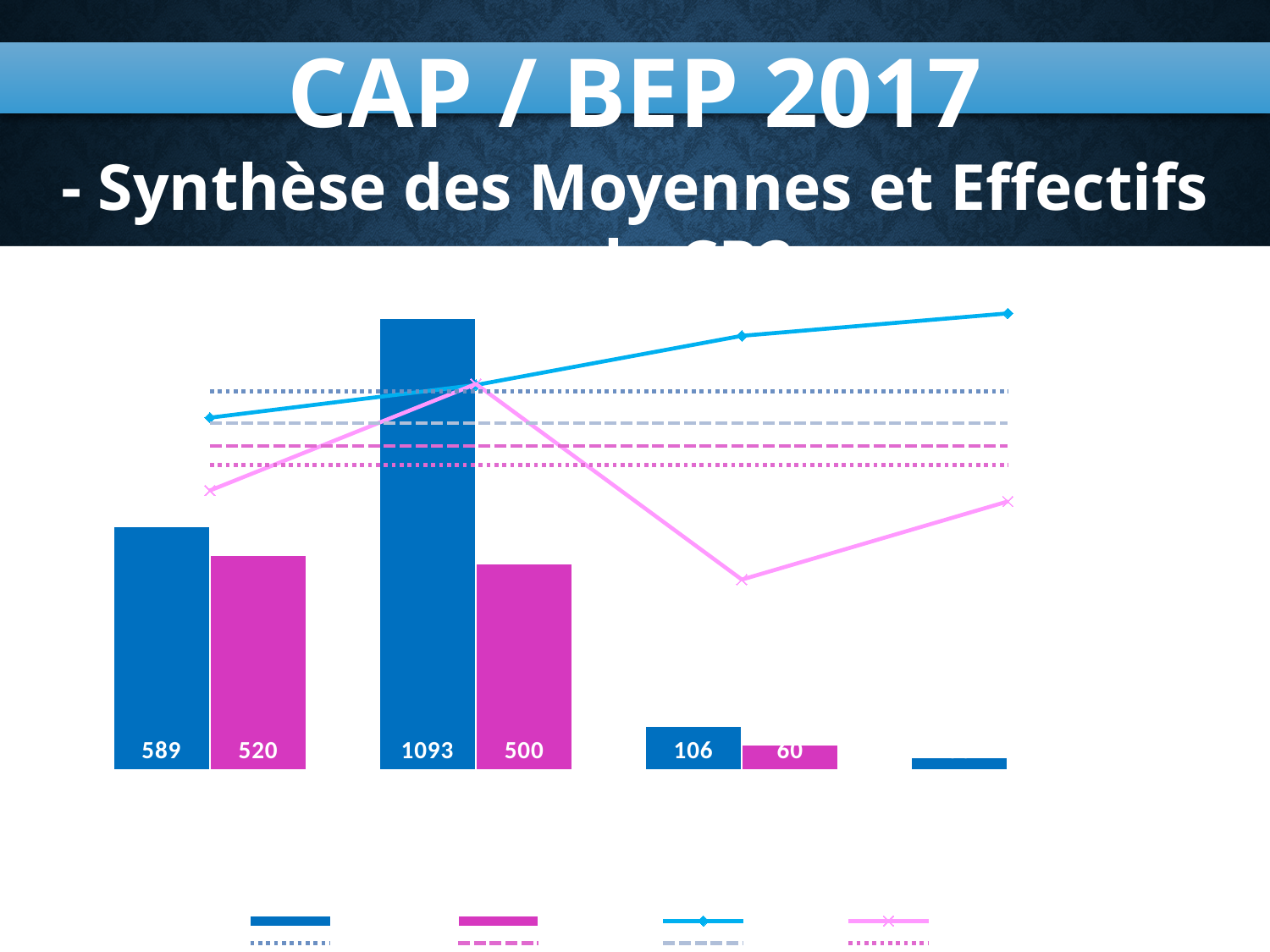
Among the labelled blue bars, which group has the smallest value? The third group (106) What is the value of the magenta bar in the second group? 500 What is the value of the magenta bar in the first (leftmost) group? 520 What is the value of the blue bar in the second group? 1093 How many groups of bars are plotted along the x axis? 4 What kind of chart is shown on the slide? A combined bar and line chart What is the value of the blue bar in the first (leftmost) group? 589 In the first group, which bar is larger, the blue one or the magenta one? The blue bar (589) What is the value of the blue bar in the third group? 106 Does the blue line with diamond markers rise or fall from left to right? It rises Which group has the tallest blue bar? The second group (1093) What is the difference between the blue bar and the magenta bar in the second group? 593